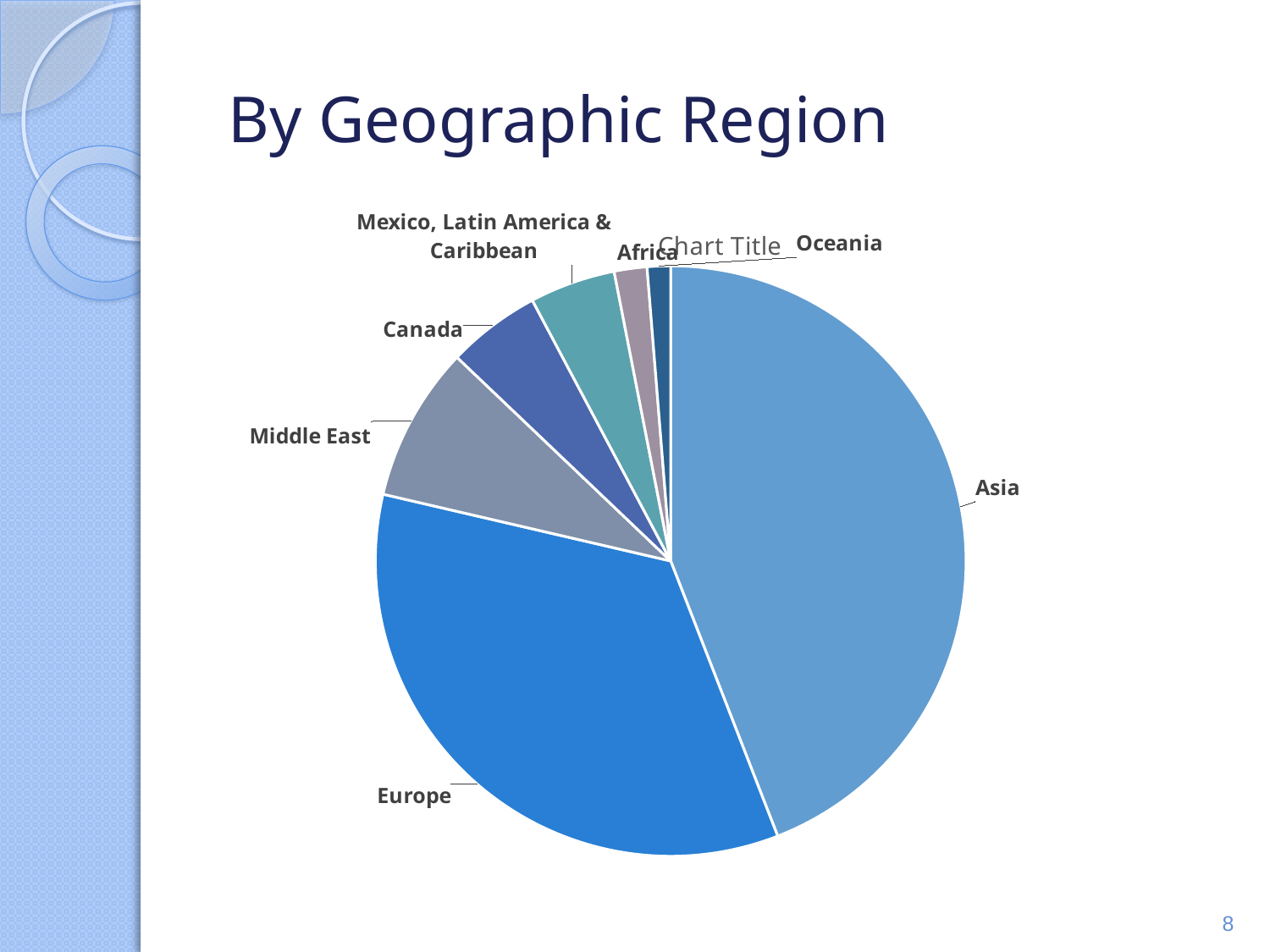
Which is larger in the pie chart, Asia or Europe? Asia Which is larger in the pie chart, Mexico, Latin America & Caribbean or Oceania? Mexico, Latin America & Caribbean What title text is printed on the chart itself? Chart Title Which is larger in the pie chart, Middle East or Canada? Middle East What kind of chart is shown on the slide? Pie chart What is the title of the slide? By Geographic Region Which region has the largest slice of the pie chart? Asia How many slices (regions) does the pie chart have? 7 Which region has the second-largest slice of the pie chart? Europe